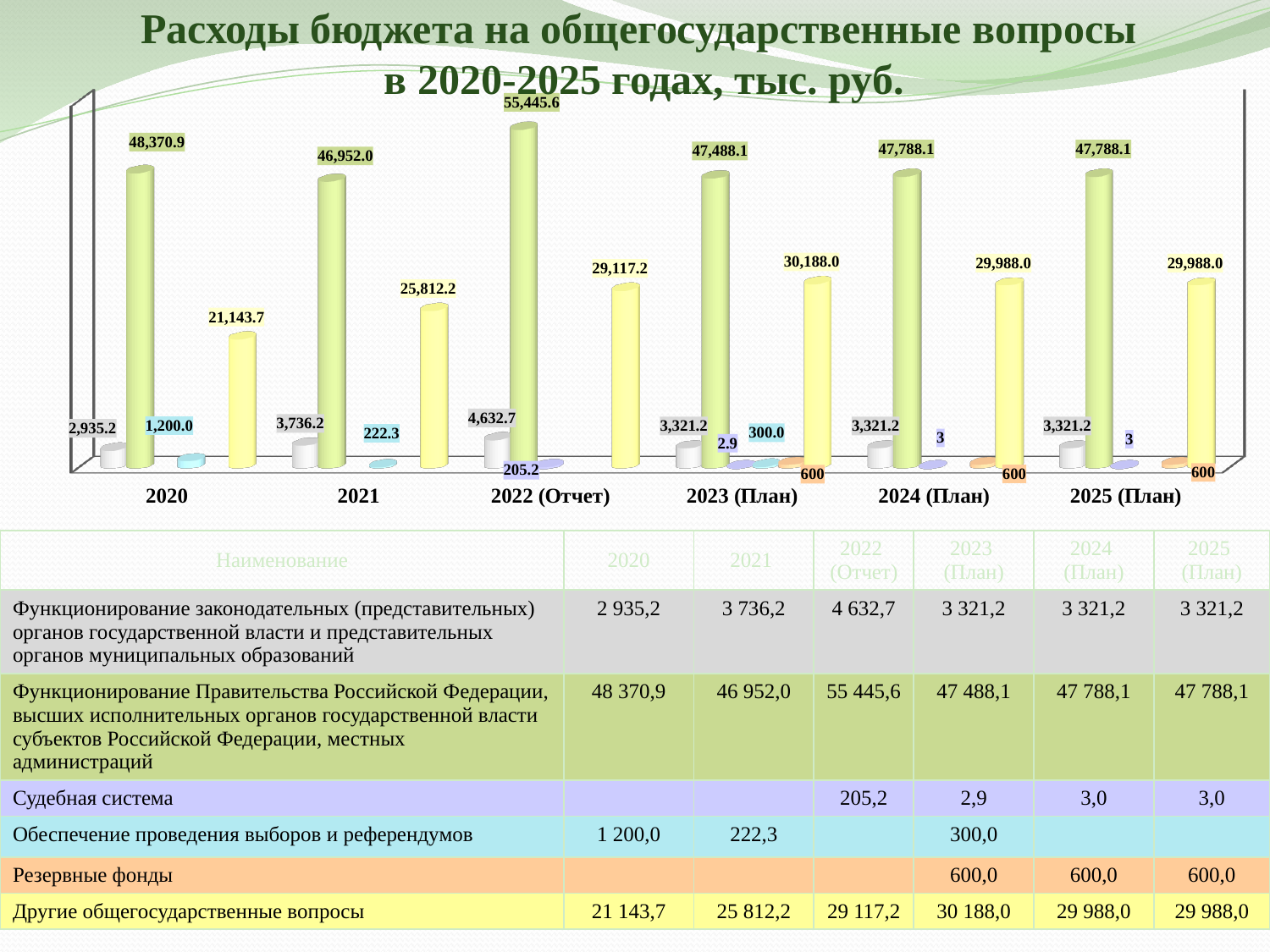
What is the value of the tallest bar (green series) for 2022 (Отчет)? 55,445.6 In which year does the green series (Функционирование Правительства) reach its highest value? 2022 (Отчет) In which year is the yellow series (Другие общегосударственные вопросы) lowest? 2020 What type of chart is shown on the slide? bar chart What is the value of the yellow bar (Другие общегосударственные вопросы) for 2021? 25,812.2 Which is larger: the yellow bar for 2023 (План) or the yellow bar for 2024 (План)? 2023 (План) How many year categories are shown along the x axis of the chart? 6 What is the value of the Резервные фонды bar for 2025 (План)? 600 What is the value of the white bar (Функционирование законодательных органов) for 2020? 2,935.2 What is the title of the chart? Расходы бюджета на общегосударственные вопросы в 2020-2025 годах, тыс. руб. What is the difference between the green bar values for 2022 (Отчет) and 2023 (План)? 7,957.5 Does the white series (Функционирование законодательных органов) rise or fall from 2022 (Отчет) to 2023 (План)? fall